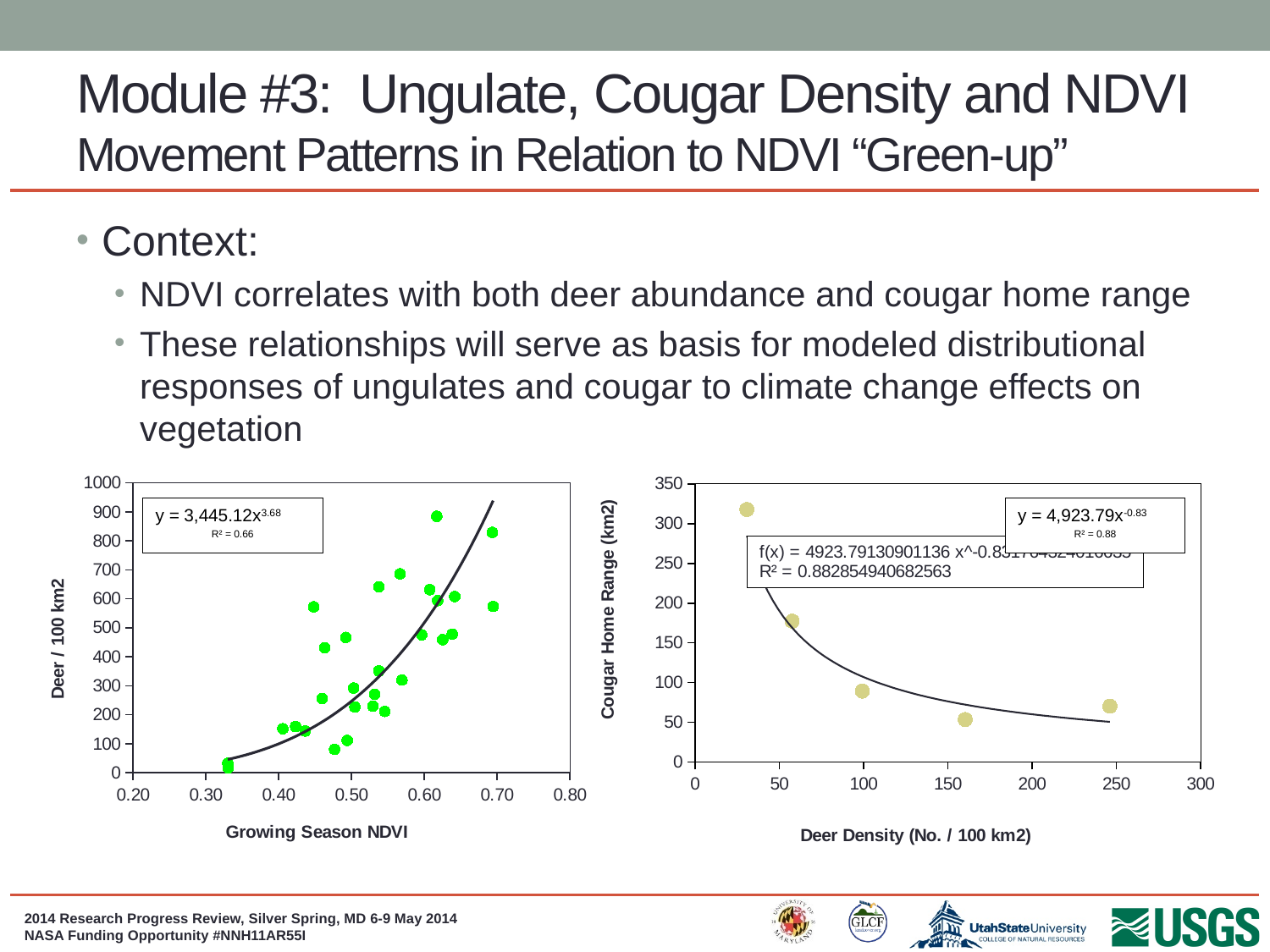
In the right chart, does cougar home range rise or fall as deer density increases along the x axis? fall In the right chart, is the cougar home range for the point with the lowest deer density greater or less than 250? greater What kind of chart is the right chart (Cougar Home Range vs Deer Density)? scatter chart In the left chart, does deer density rise or fall as Growing Season NDVI increases along the x axis? rise What R² value is shown for the trendline in the left chart? 0.66 What kind of chart is the left chart (Deer / 100 km2 vs Growing Season NDVI)? scatter chart What R² value is shown in the equation box at the top right of the right chart? 0.88 In the right chart, is the cougar home range for the point with the highest deer density (near 250) greater or less than 100? less In the left chart, is the deer density for the point with the lowest NDVI (near 0.33) greater or less than 100? less How many data points are plotted in the right chart (Cougar Home Range vs Deer Density)? 5